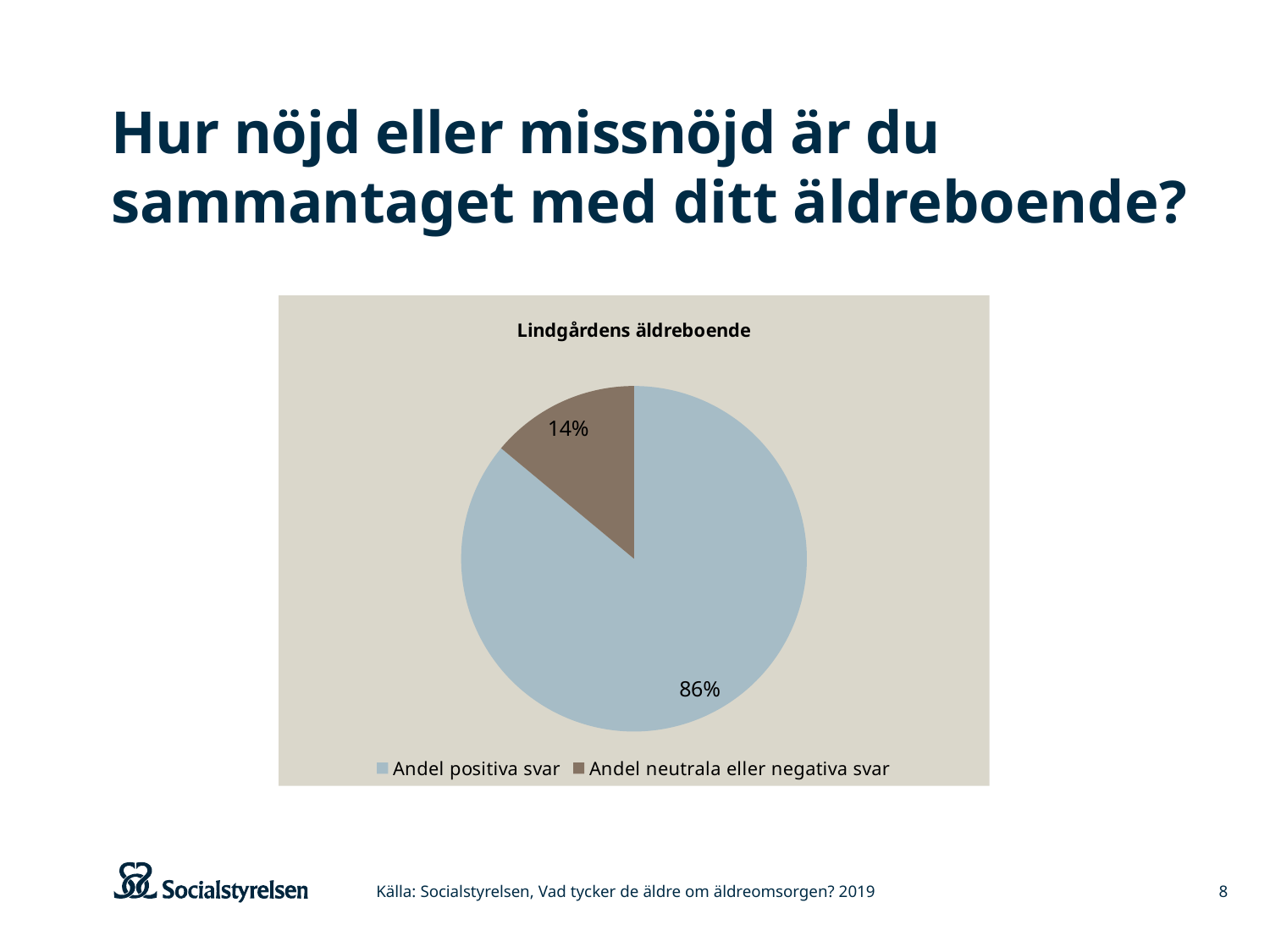
Which slice is the smallest? Andel neutrala eller negativa svar How many entries does the legend list? 2 What is the title of the chart? Lindgårdens äldreboende How many slices does the pie chart have? 2 What kind of chart is shown on the slide? Pie chart Which is larger: 'Andel positiva svar' or 'Andel neutrala eller negativa svar'? Andel positiva svar What share of the pie is 'Andel positiva svar'? 86% What colour is the 'Andel neutrala eller negativa svar' slice? Brown What share of the pie is 'Andel neutrala eller negativa svar'? 14% What is the difference in percentage points between 'Andel positiva svar' and 'Andel neutrala eller negativa svar'? 72 percentage points Which slice is the largest? Andel positiva svar